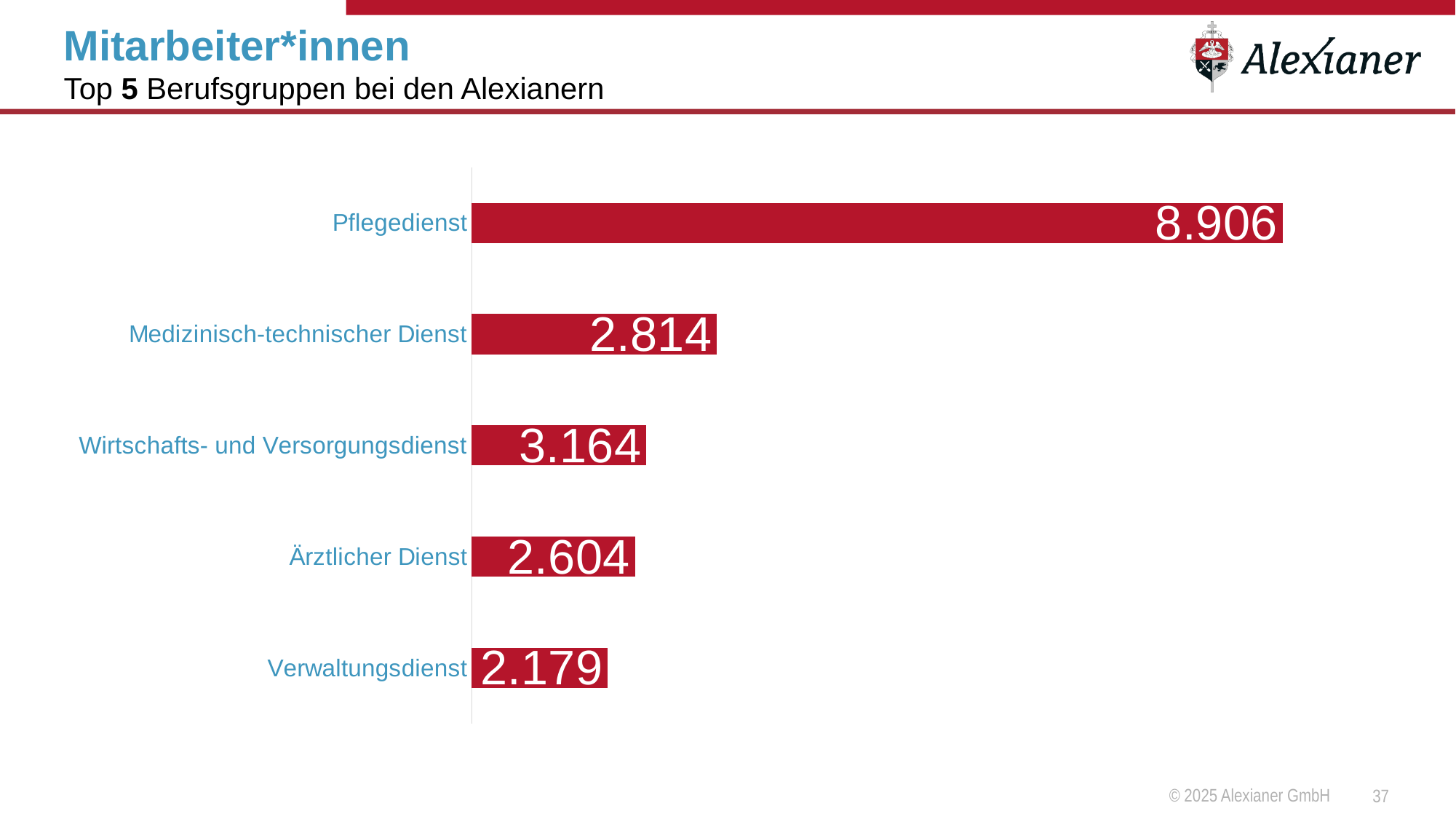
Which category has the highest value? Pflegedienst What kind of chart is shown on the slide? Bar chart What is the difference between the values for Ärztlicher Dienst and Verwaltungsdienst? 425 How many categories are shown in the chart? 5 Which is larger, the value for Pflegedienst or the value for Ärztlicher Dienst? Pflegedienst What is the value for Ärztlicher Dienst? 2.604 What is the difference between the values for Pflegedienst and Verwaltungsdienst? 6.727 Which category has the lowest value? Verwaltungsdienst What is the value for Medizinisch-technischer Dienst? 2.814 What is the value for Wirtschafts- und Versorgungsdienst? 3.164 What is the value for Pflegedienst? 8.906 What is the value for Verwaltungsdienst? 2.179